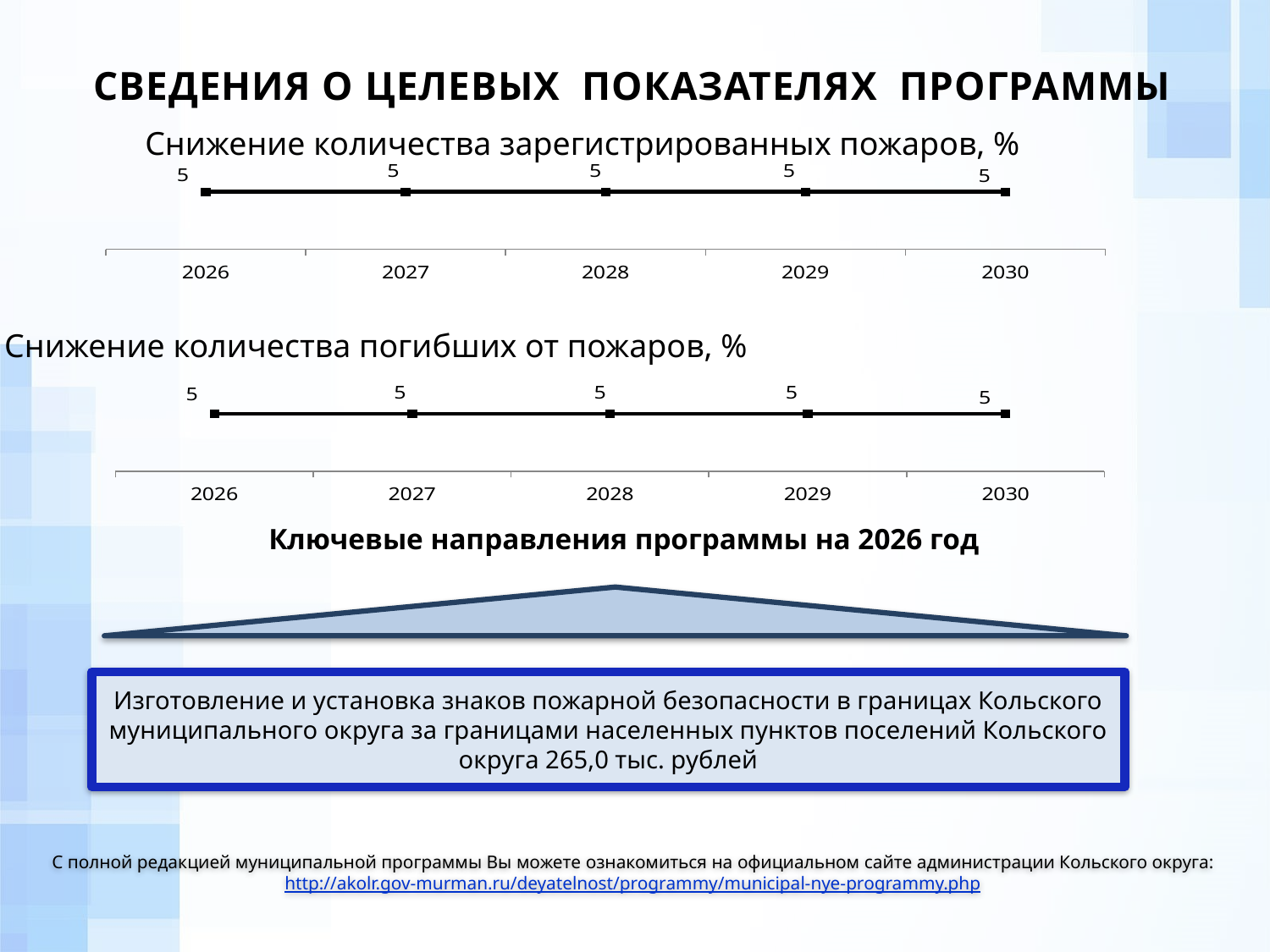
How many years are shown on the x axis of the chart titled "Снижение количества погибших от пожаров, %"? 5 What kind of chart is the lower chart, "Снижение количества погибших от пожаров, %"? line chart What is the first year shown on the x axis of the upper chart? 2026 What is the title of the lower chart on the slide? Снижение количества погибших от пожаров, % How many data points are plotted in the chart titled "Снижение количества зарегистрированных пожаров, %"? 5 In the chart titled "Снижение количества зарегистрированных пожаров, %", what is the value for 2026? 5 In the chart titled "Снижение количества погибших от пожаров, %", what is the value for 2028? 5 What kind of chart is the upper chart, "Снижение количества зарегистрированных пожаров, %"? line chart In the chart titled "Снижение количества зарегистрированных пожаров, %", do the values rise, fall or stay flat from 2026 to 2030? stay flat In the chart titled "Снижение количества погибших от пожаров, %", do the values rise, fall or stay flat from 2026 to 2030? stay flat In the chart titled "Снижение количества погибших от пожаров, %", what is the value for 2029? 5 In the chart titled "Снижение количества зарегистрированных пожаров, %", what is the value for 2030? 5